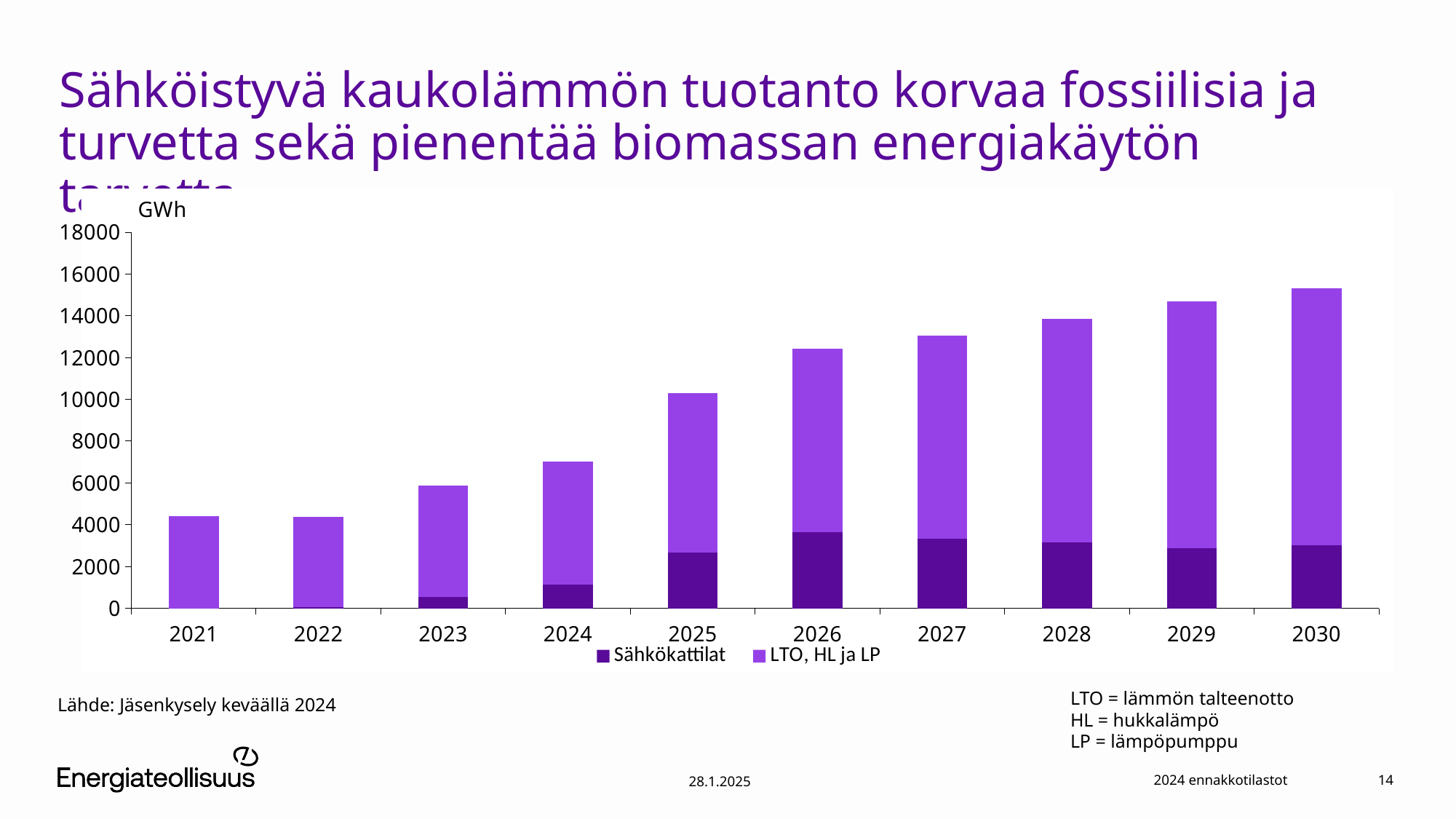
Is the Sähkökattilat value for 2024 greater or less than 2000? less Do the total bar heights generally rise or fall from 2021 to 2030? Rise How many years are shown on the x axis of the chart? 10 Is the total value for 2030 greater or less than 14000? greater Is the Sähkökattilat value for 2026 greater or less than 2000? greater Which year has the larger total bar, 2021 or 2030? 2030 What kind of chart is shown on the slide? Stacked bar chart How many series does the chart legend list? 2 What unit is shown at the top of the y axis? GWh Which year has the highest total bar in the chart? 2030 What are the two series named in the chart legend? Sähkökattilat; LTO, HL ja LP